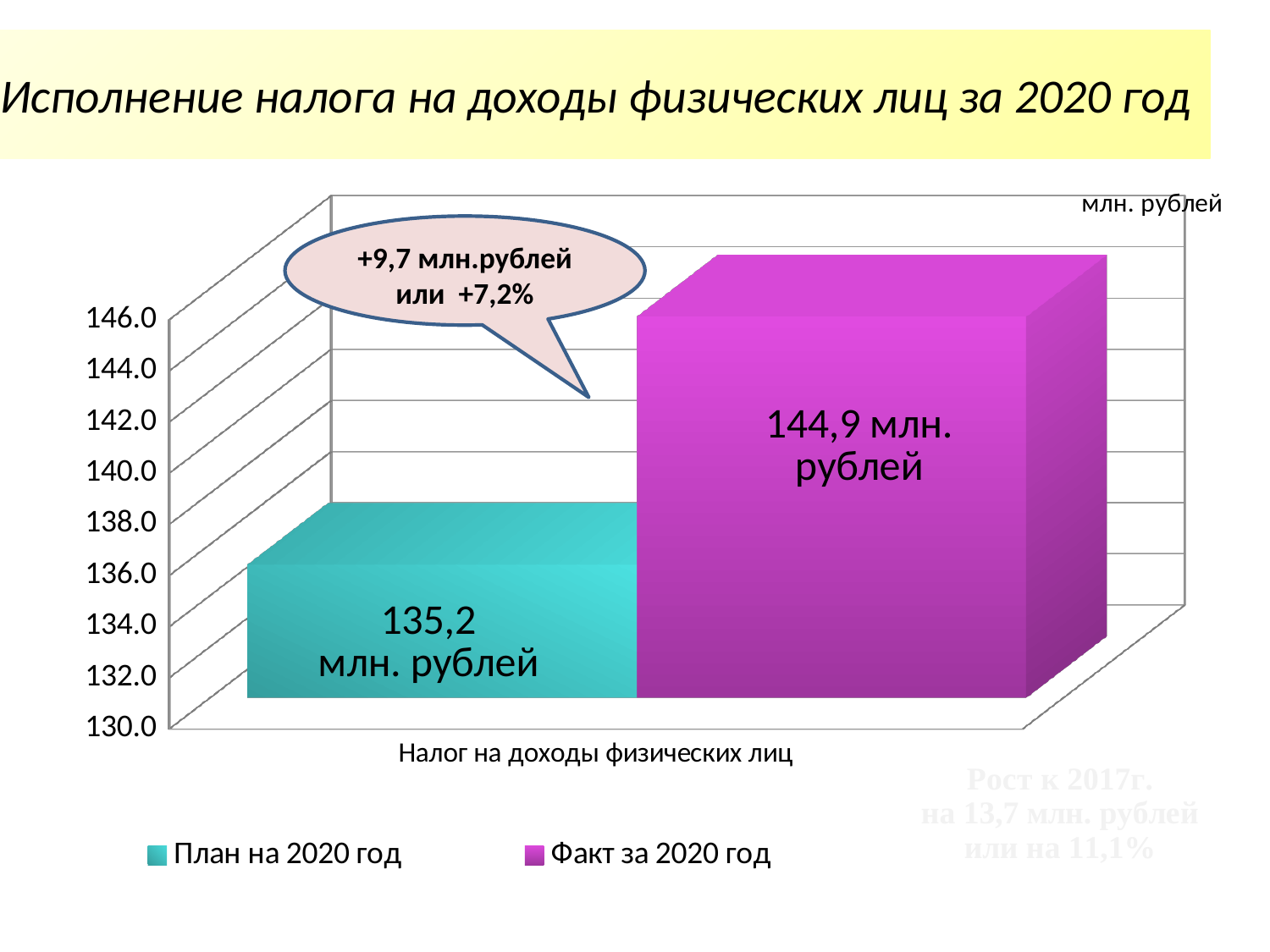
What is the difference between the "Факт за 2020 год" value and the "План на 2020 год" value? 9,7 млн. рублей What is the value for the series "Факт за 2020 год"? 144,9 млн. рублей Which series has the lowest value on the chart? План на 2020 год Is the value for "Факт за 2020 год" greater or less than 140.0? greater What is the title of the slide? Исполнение налога на доходы физических лиц за 2020 год What is the value for the series "План на 2020 год"? 135,2 млн. рублей Which series has the higher value, "План на 2020 год" or "Факт за 2020 год"? Факт за 2020 год What kind of chart is shown on the slide? Bar chart Is the value for "План на 2020 год" greater or less than 140.0? less By what percentage does the fact exceed the plan, according to the callout on the chart? +7,2% How many series does the legend list? 2 How many categories are shown on the x axis? 1